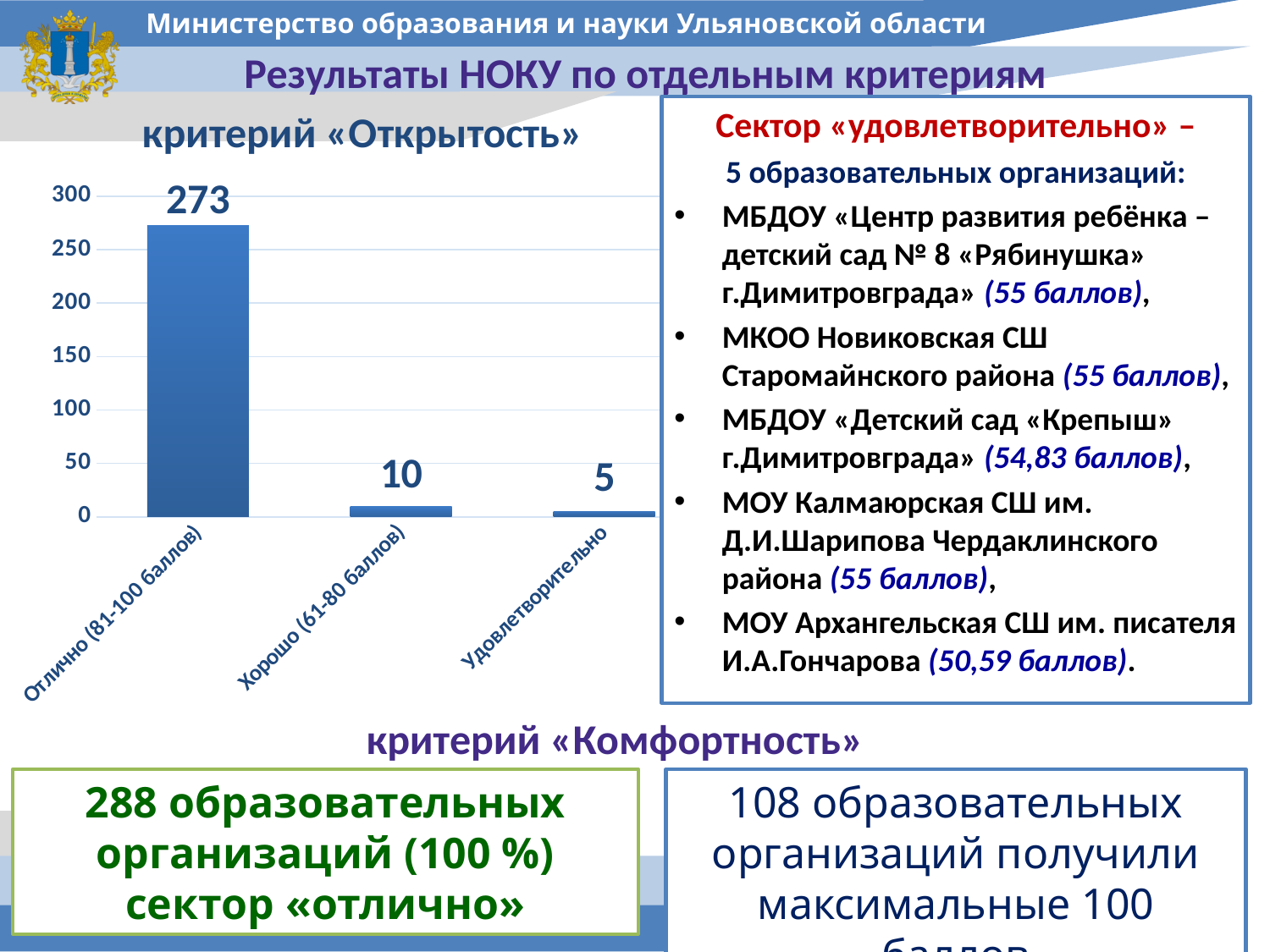
How many categories are shown in the chart? 3 What is the difference between the values for «Отлично (81-100 баллов)» and «Хорошо (61-80 баллов)»? 263 What is the difference between the values for «Хорошо (61-80 баллов)» and «Удовлетворительно»? 5 Is the value for «Отлично (81-100 баллов)» greater or less than 250? greater What type of chart is shown on the slide? bar chart Which category has the lowest value in the chart? Удовлетворительно Which is larger: the value for «Хорошо (61-80 баллов)» or the value for «Удовлетворительно»? Хорошо (61-80 баллов) What is the value for the category «Удовлетворительно» in the chart? 5 What is the value for the category «Хорошо (61-80 баллов)» in the chart? 10 What is the value for the category «Отлично (81-100 баллов)» in the chart «критерий «Открытость»»? 273 What is the title of the chart on the slide? критерий «Открытость» Which category has the highest value in the chart? Отлично (81-100 баллов)